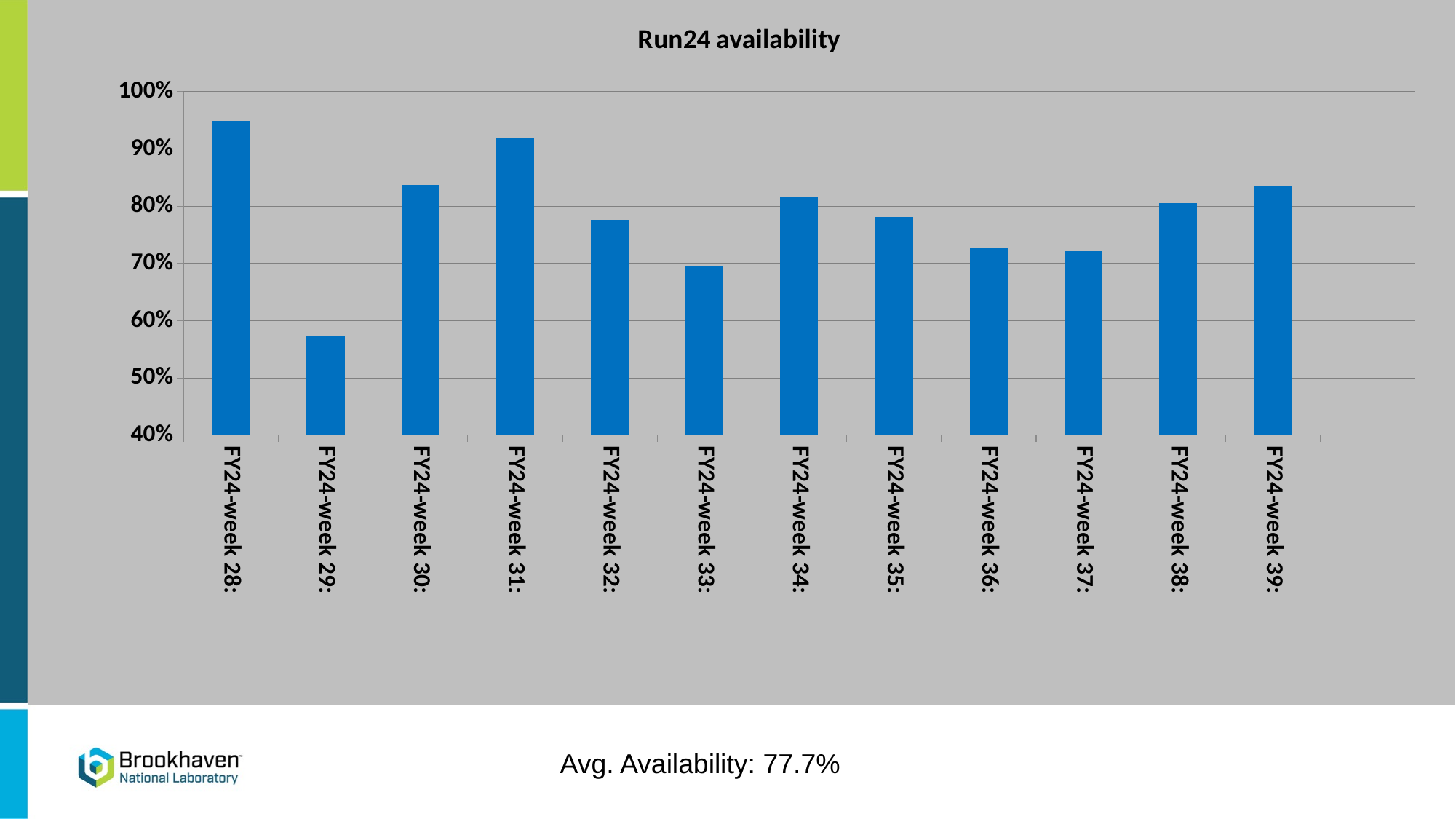
Which week has the lowest availability? FY24-week 29 How many weeks are plotted on the chart? 12 Is the value for FY24-week 30 greater or less than 80%? greater What average availability is stated below the chart? 77.7% What is the title of the chart? Run24 availability Is the value for FY24-week 28 greater or less than 90%? greater Is the value for FY24-week 29 greater or less than 60%? less Do the values rise or fall from FY24-week 31 to FY24-week 33? fall Which week has the highest availability? FY24-week 28 What kind of chart is shown on the slide? bar chart Which is larger, the availability for FY24-week 31 or FY24-week 32? FY24-week 31